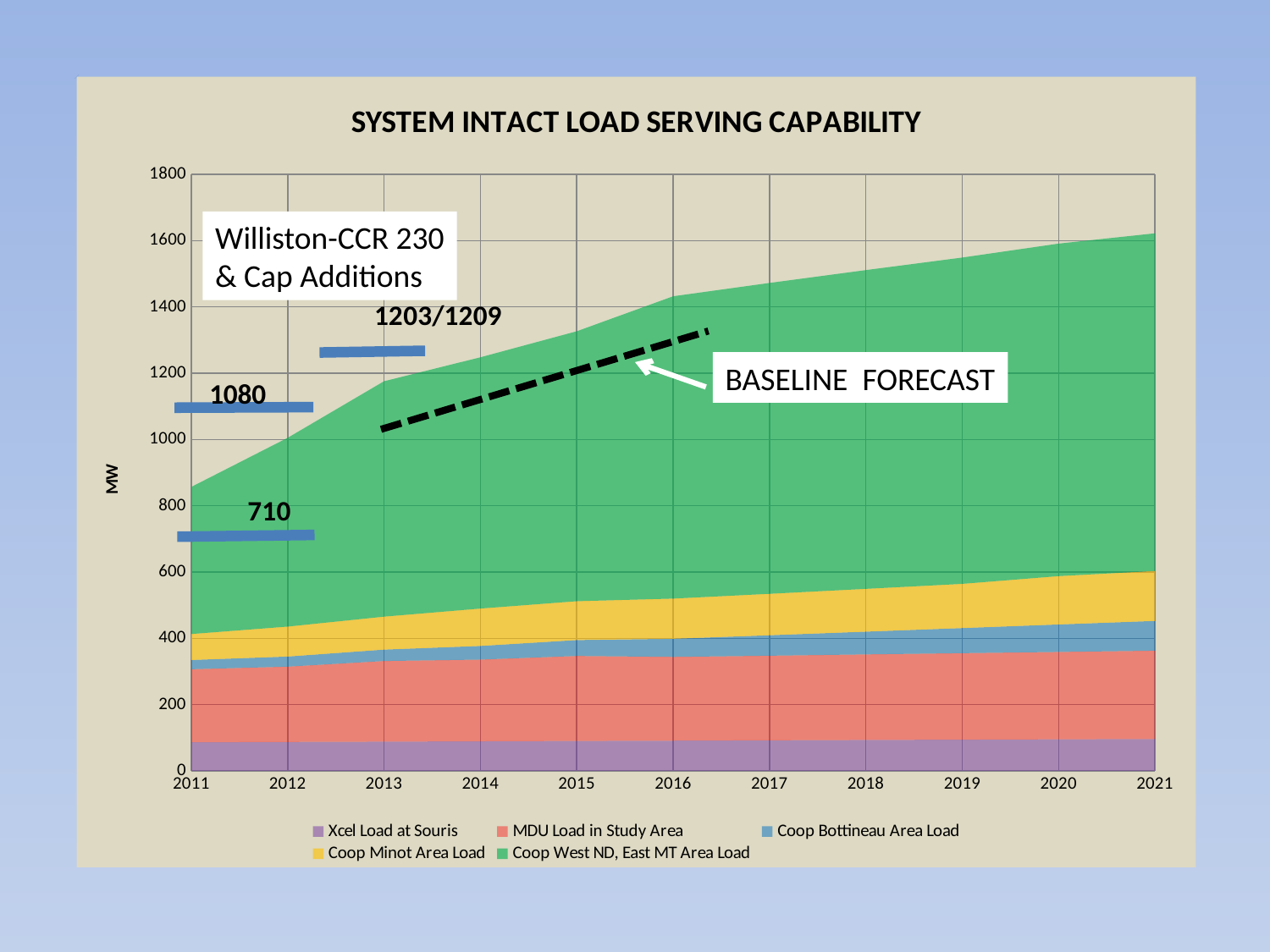
Does the total stacked load rise or fall from 2011 to 2021? Rise Is the total stacked load in 2011 greater or less than 1000? less Which series occupies the largest band of the stacked area in 2021? Coop West ND, East MT Area Load How many years are shown along the x axis? 11 How many series does the legend list? 5 What value is labeled on the lowest blue capability bar near 2011-2012? 710 Is the total stacked load in 2021 greater or less than 1400? greater Is the value for Xcel Load at Souris in 2011 greater or less than 200? less What type of chart is shown on the slide? Stacked area chart What unit is shown on the y axis label? MW What is the title of the chart? SYSTEM INTACT LOAD SERVING CAPABILITY What value is labeled on the blue capability bar near 2013? 1203/1209